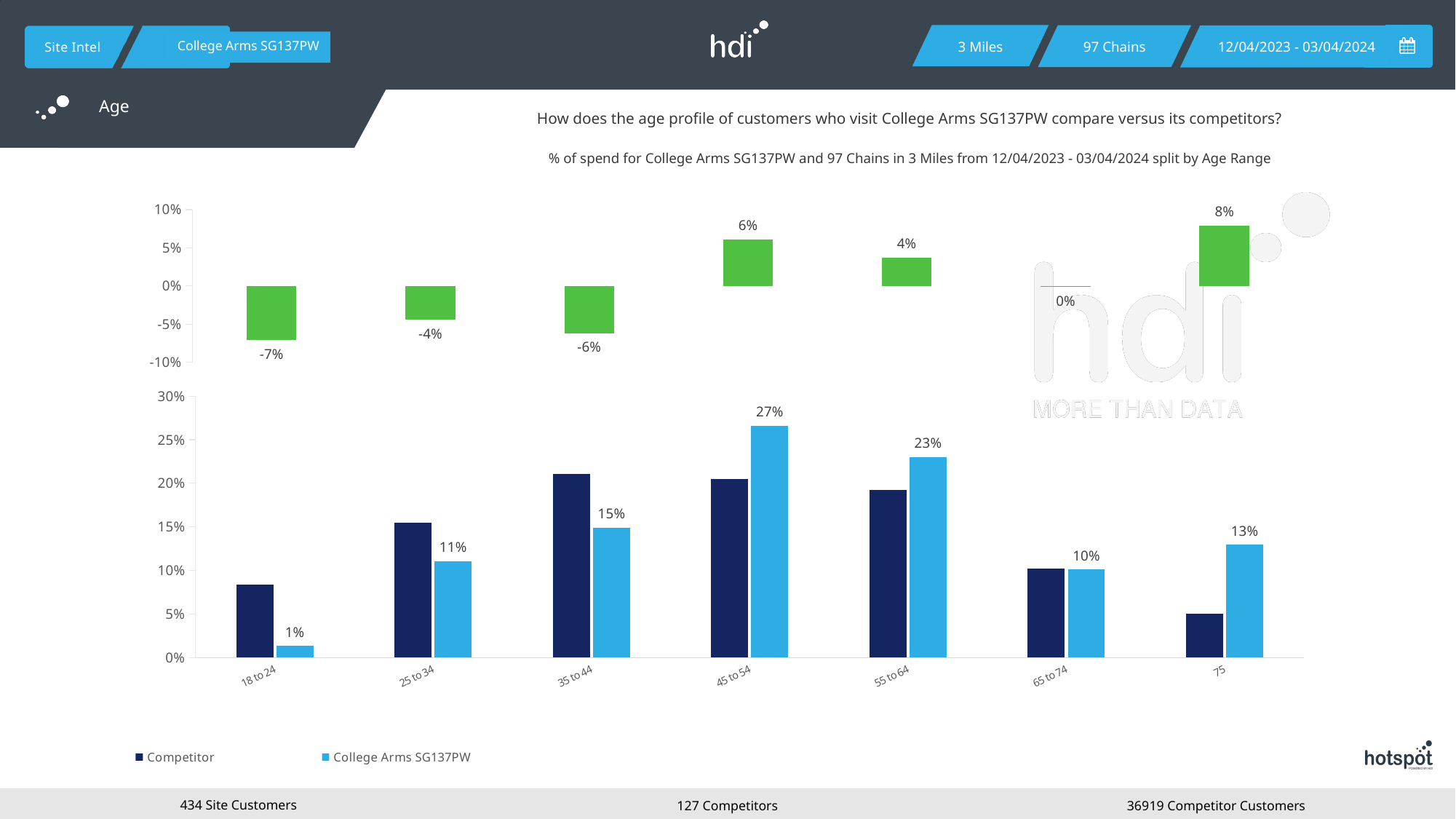
In the bottom chart, for the 35 to 44 age range, which is larger: the Competitor bar or the College Arms SG137PW bar? Competitor In the bottom chart, which age range has the highest College Arms SG137PW value? 45 to 54 In the top chart, what is the value shown for the 18 to 24 age range? -7% In the bottom chart, what is the difference between the College Arms SG137PW values for 45 to 54 and 55 to 64? 4% How many age ranges are shown on the x axis of the bottom chart? 7 In the bottom chart, what is the value for College Arms SG137PW in the 45 to 54 age range? 27% How many series does the legend of the bottom chart list? 2 In the top chart, which age range has the highest value? 75 In the bottom chart, is the Competitor value for 18 to 24 greater or less than 10%? less In the bottom chart, which age range has the lowest College Arms SG137PW value? 18 to 24 In the bottom chart, what is the value for College Arms SG137PW in the 18 to 24 age range? 1% In the bottom chart, is the Competitor value for 35 to 44 greater or less than 20%? greater